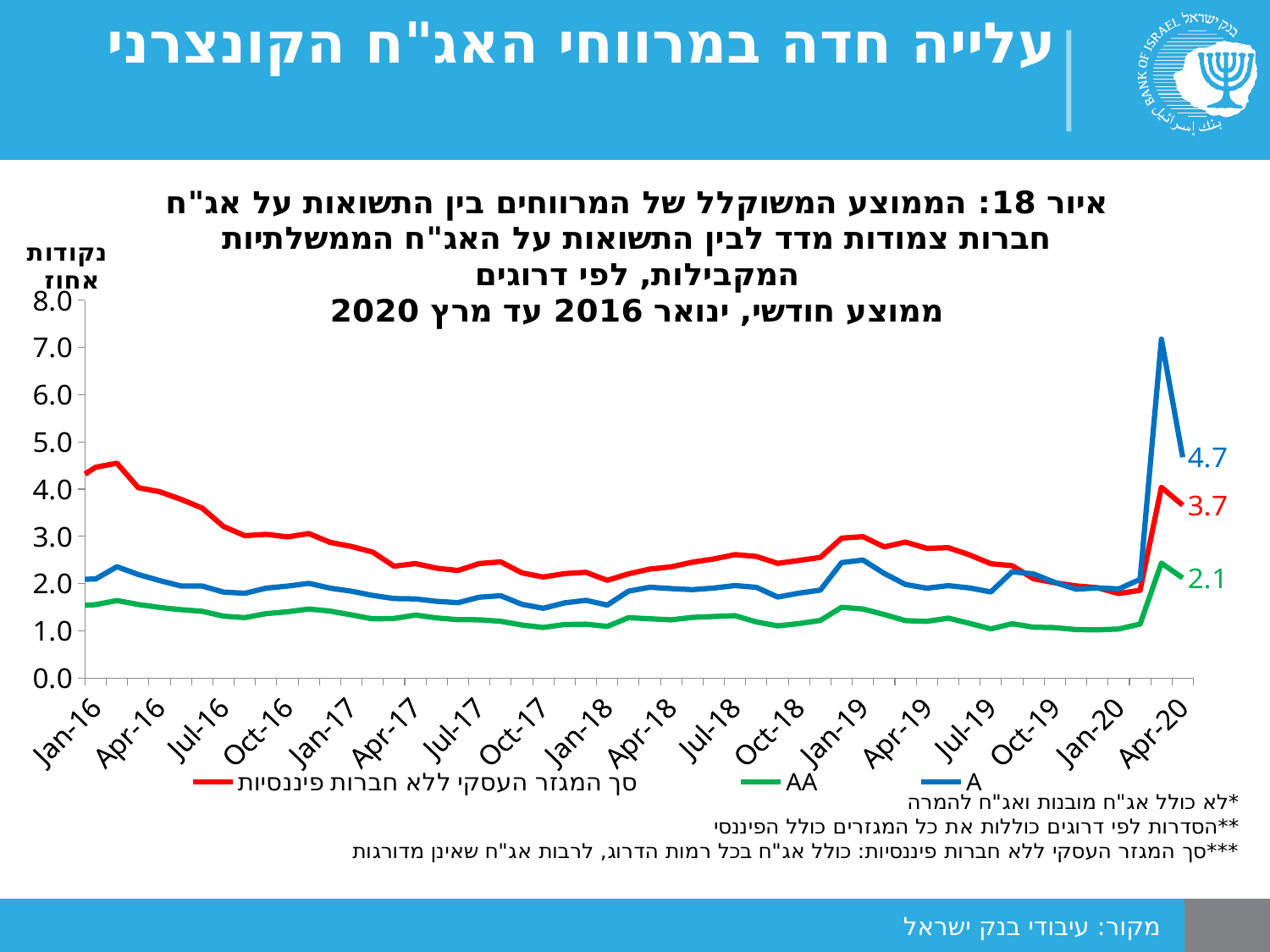
Which series has the highest final labelled value? A How many series does the legend list? 3 What is the last labelled value of the series 'סך המגזר העסקי ללא חברות פיננסיות'? 3.7 Is the peak value of the A series greater or less than 6.0? greater Which series has the lowest final labelled value? AA What is the difference between the final labelled values of the A series and the AA series? 2.6 What kind of chart is shown on the slide? line chart Is the value for the AA series at Jan-16 greater or less than 2.0? less What is the last labelled value of the A series? 4.7 Does the A series rise or fall between Jan-20 and its peak in 2020? rise What is the difference between the final labelled values of the A series and the 'סך המגזר העסקי ללא חברות פיננסיות' series? 1.0 What is the last labelled value of the AA series? 2.1